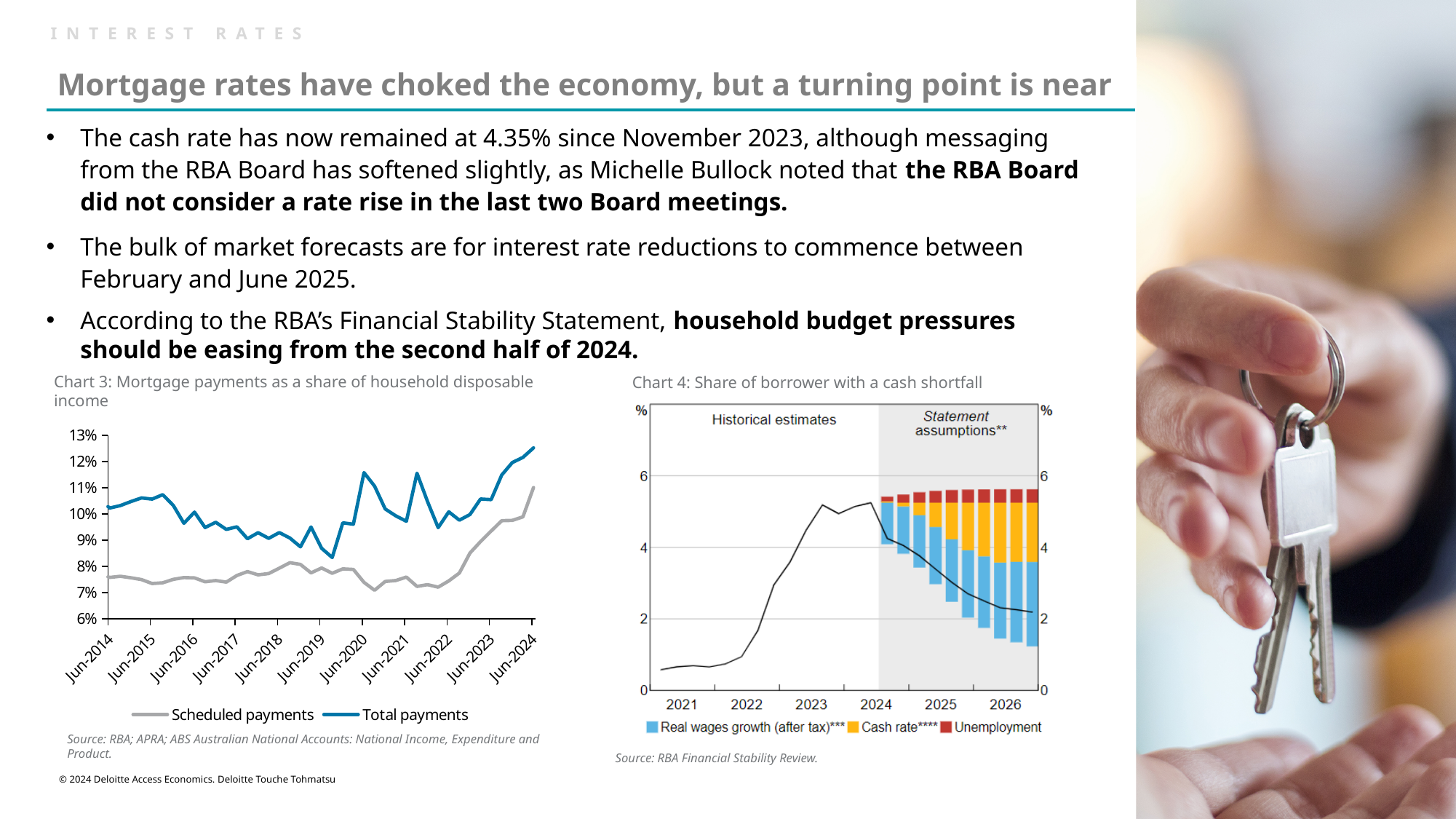
In Chart 3, is the value for Total payments at Jun-2024 greater or less than 12%? greater In Chart 4, is the peak of the black line in 2023 greater or less than 5? greater In Chart 4, which legend entry is shown in yellow? Cash rate**** In Chart 3, what is the highest value shown on the vertical axis? 13% In Chart 4, how many series does the legend list? 3 In Chart 3, is the value for Total payments at Jun-2019 greater or less than 9%? less In Chart 3, which series is higher at Jun-2024, Scheduled payments or Total payments? Total payments In Chart 3, what kind of chart is used to show mortgage payments as a share of household disposable income? line chart In Chart 3, do Total payments rise or fall between Jun-2022 and Jun-2024? rise In Chart 3, how many series does the legend list? 2 In Chart 4, does the black line rise or fall between 2024 and 2026? fall